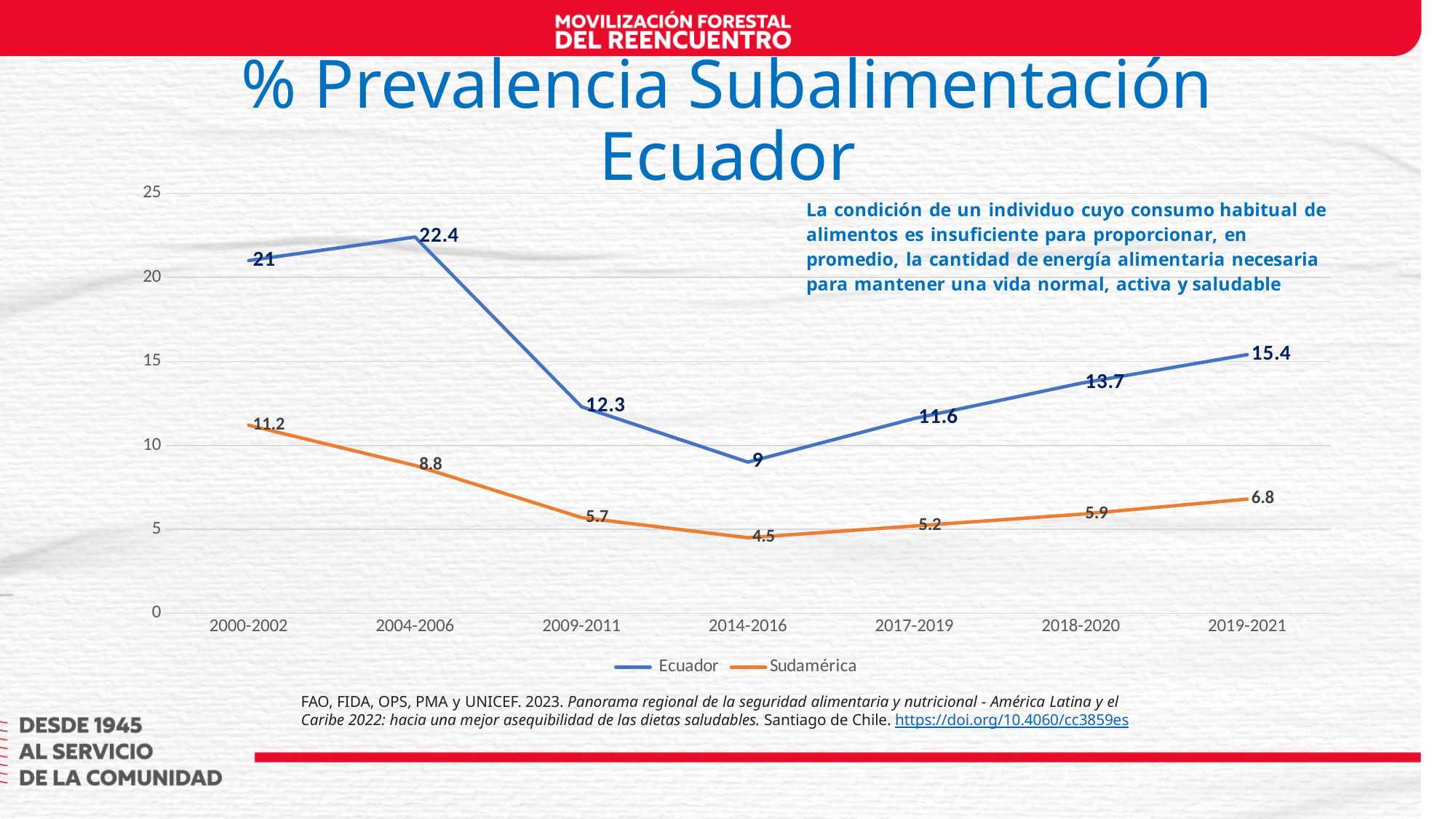
What is the difference between Ecuador and Sudamérica in 2019-2021? 8.6 What is the value for Sudamérica in 2014-2016? 4.5 What kind of chart is shown? Line chart What is the value for Ecuador in 2019-2021? 15.4 What is the value for Ecuador in 2004-2006? 22.4 In which period is the Sudamérica series lowest? 2014-2016 How many series does the legend list? 2 How many periods are shown on the x axis? 7 Is the value for Ecuador in 2000-2002 greater or less than 20? greater In which period is the Ecuador series highest? 2004-2006 Which is larger in 2009-2011, Ecuador or Sudamérica? Ecuador Does the Ecuador series rise or fall from 2014-2016 to 2019-2021? Rise